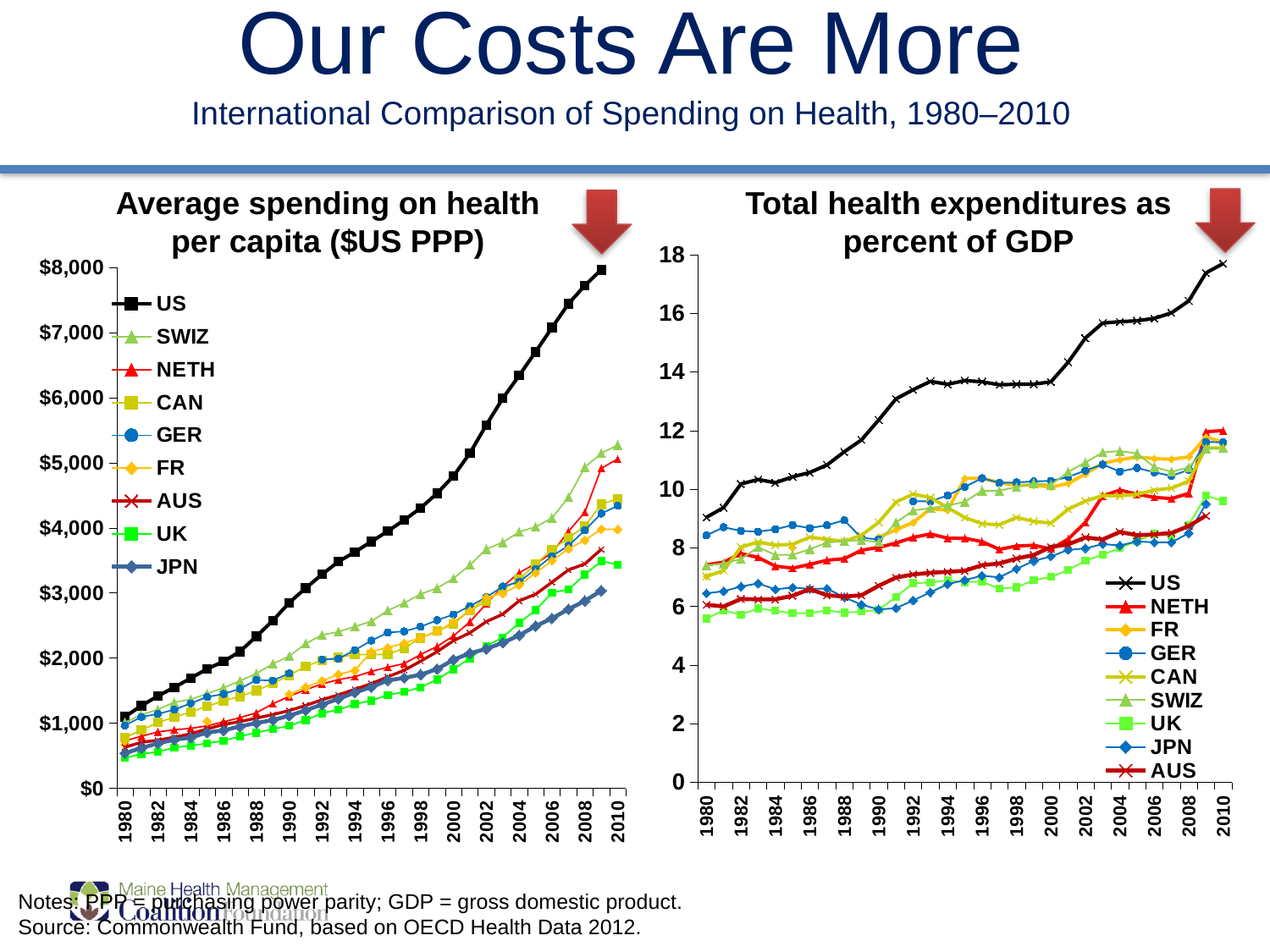
In the left chart, 'Average spending on health per capita ($US PPP)', which country has the highest spending at the end of the period? US What type of chart is the right chart, 'Total health expenditures as percent of GDP'? line chart In the left chart, 'Average spending on health per capita ($US PPP)', which country has the lowest spending in 2010? UK In the right chart, 'Total health expenditures as percent of GDP', is the US value for 2010 greater or less than 16? greater What type of chart is the left chart, 'Average spending on health per capita ($US PPP)'? line chart In the right chart, 'Total health expenditures as percent of GDP', which country has the highest value in 2010? US How many series does the legend of the left chart, 'Average spending on health per capita ($US PPP)', list? 9 In the right chart, 'Total health expenditures as percent of GDP', which is larger in 2010, the value for US or the value for UK? US In the right chart, 'Total health expenditures as percent of GDP', does the US line rise or fall from 1980 to 2010? rise In the left chart, 'Average spending on health per capita ($US PPP)', is the UK value for 2010 greater or less than $4,000? less In the left chart, 'Average spending on health per capita ($US PPP)', is the US value for 2000 greater or less than $4,000? greater How many series does the legend of the right chart, 'Total health expenditures as percent of GDP', list? 9